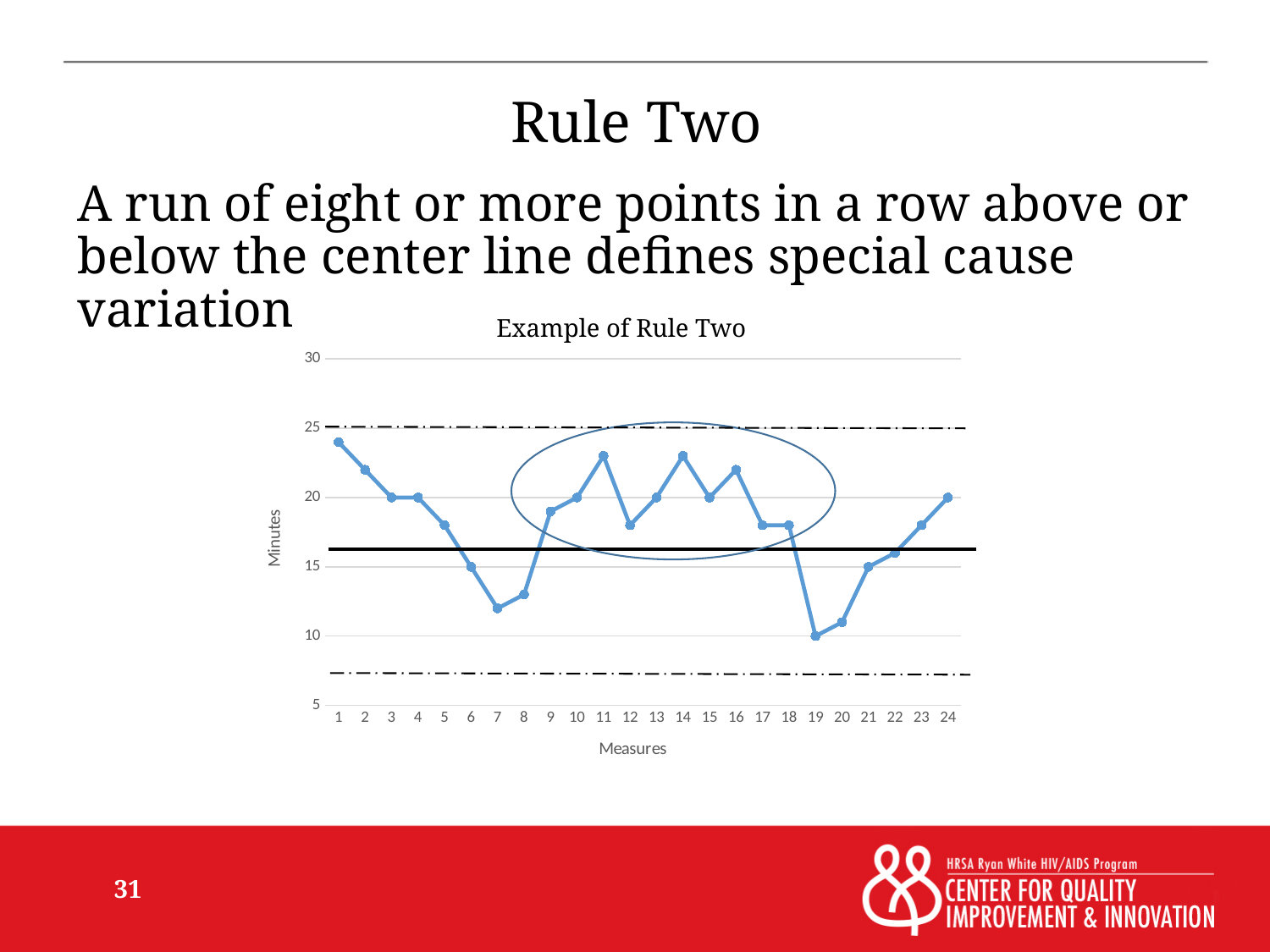
How many measures (data points) are plotted on the chart? 24 What is the value in minutes at measure 24? 20 Is the value for measure 11 greater or less than 20? greater Do the values rise or fall from measure 19 to measure 24? rise What is the label on the vertical axis of the chart? Minutes Is the value for measure 7 greater or less than 15? less What kind of chart is shown on the slide? line chart What is the title of the chart? Example of Rule Two What is the value in minutes at measure 19? 10 Which has the larger value, measure 7 or measure 11? measure 11 What is the value in minutes at measure 3? 20 Which measure has the lowest value on the chart? 19